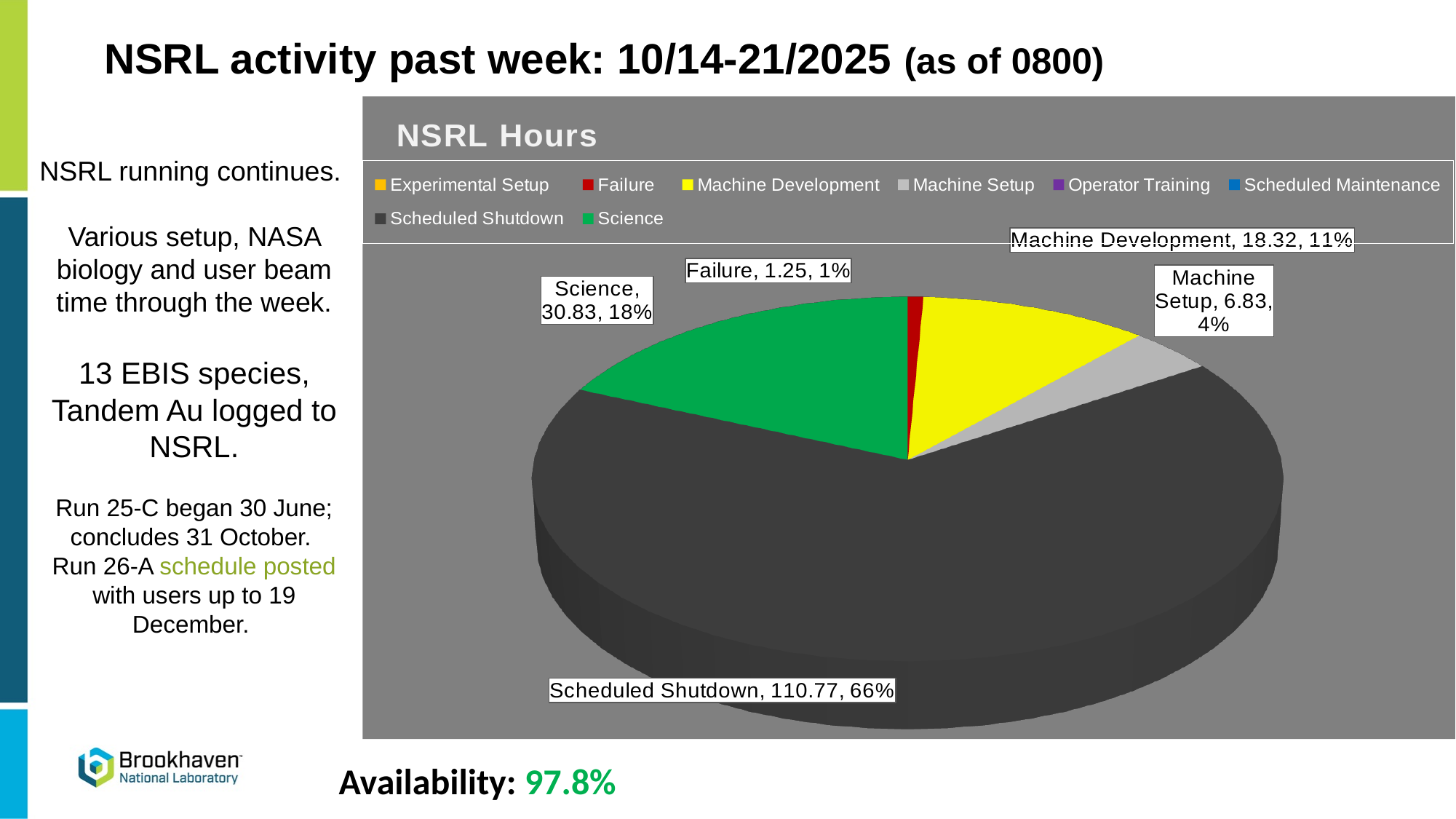
How many entries does the chart legend list? 8 What percentage share of the pie does Scheduled Shutdown have? 66% What type of chart is shown on the slide? Pie chart How many hours are labeled for Science? 30.83 Which category has the largest slice of the pie? Scheduled Shutdown Which has more hours, Machine Setup or Failure? Machine Setup How many hours are labeled for Scheduled Shutdown? 110.77 Among the labeled slices, which category has the smallest value? Failure What is the difference in hours between Science and Machine Development? 12.51 What is the title of the chart? NSRL Hours What percentage share of the pie does Machine Setup have? 4% How many hours are labeled for Machine Development? 18.32